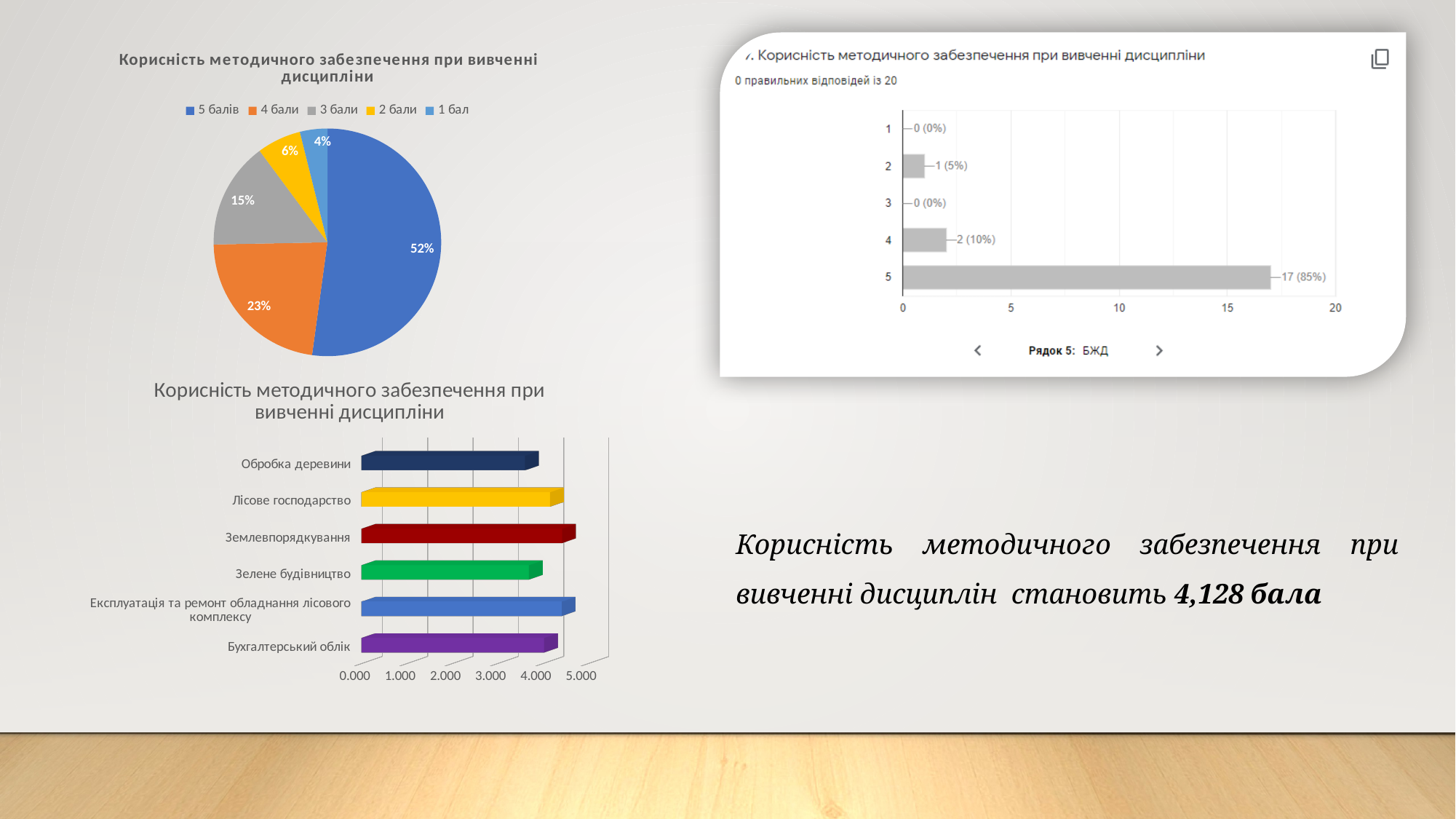
How many categories are shown in the bar chart at the bottom left of the slide? 6 In the bar chart at the bottom left, is the value for 'Землевпорядкування' greater or less than 4.000? greater In the chart at the top right of the slide, which category has the highest value? 5 In the pie chart at the top left, what is the difference between the shares of '3 бали' and '2 бали'? 9% In the pie chart titled 'Корисність методичного забезпечення при вивченні дисципліни', what share does '5 балів' have? 52% In the pie chart at the top left, which is larger: the share for '4 бали' or the share for '3 бали'? 4 бали In the pie chart at the top left, what percentage is shown for '4 бали'? 23% How many entries does the legend of the pie chart at the top left list? 5 In the chart at the top right of the slide, what value is shown for category 4? 2 (10%) In the chart at the top right of the slide, what value is shown for category 5? 17 (85%) In the pie chart at the top left, which category has the smallest slice? 1 бал What kind of chart is shown at the bottom left of the slide? bar chart